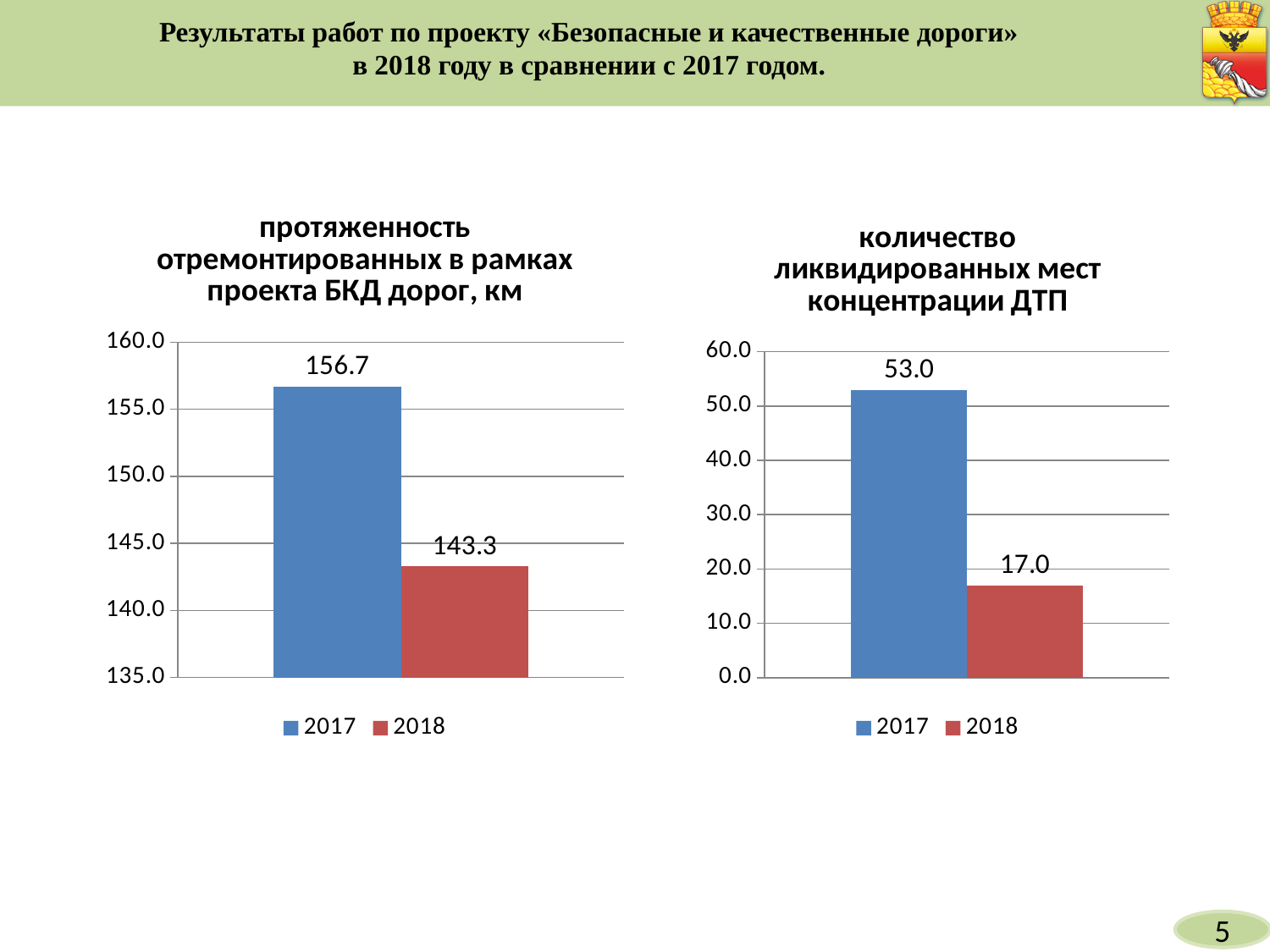
In the left chart (протяженность отремонтированных в рамках проекта БКД дорог, км), what is the value for 2018? 143.3 In the left chart, what is the difference between the 2017 and 2018 values? 13.4 In the right chart, which year has the lower value? 2018 In the right chart, is the value for 2018 greater or less than 20.0? less How many series does the legend of the left chart list? 2 In the right chart, which colour represents 2018? red What kind of chart is the right chart? bar chart In the right chart (количество ликвидированных мест концентрации ДТП), what is the value for 2018? 17.0 In the left chart (протяженность отремонтированных в рамках проекта БКД дорог, км), what is the value for 2017? 156.7 In the left chart, which year has the higher value? 2017 In the right chart, what is the difference between the 2017 and 2018 values? 36.0 In the right chart (количество ликвидированных мест концентрации ДТП), what is the value for 2017? 53.0